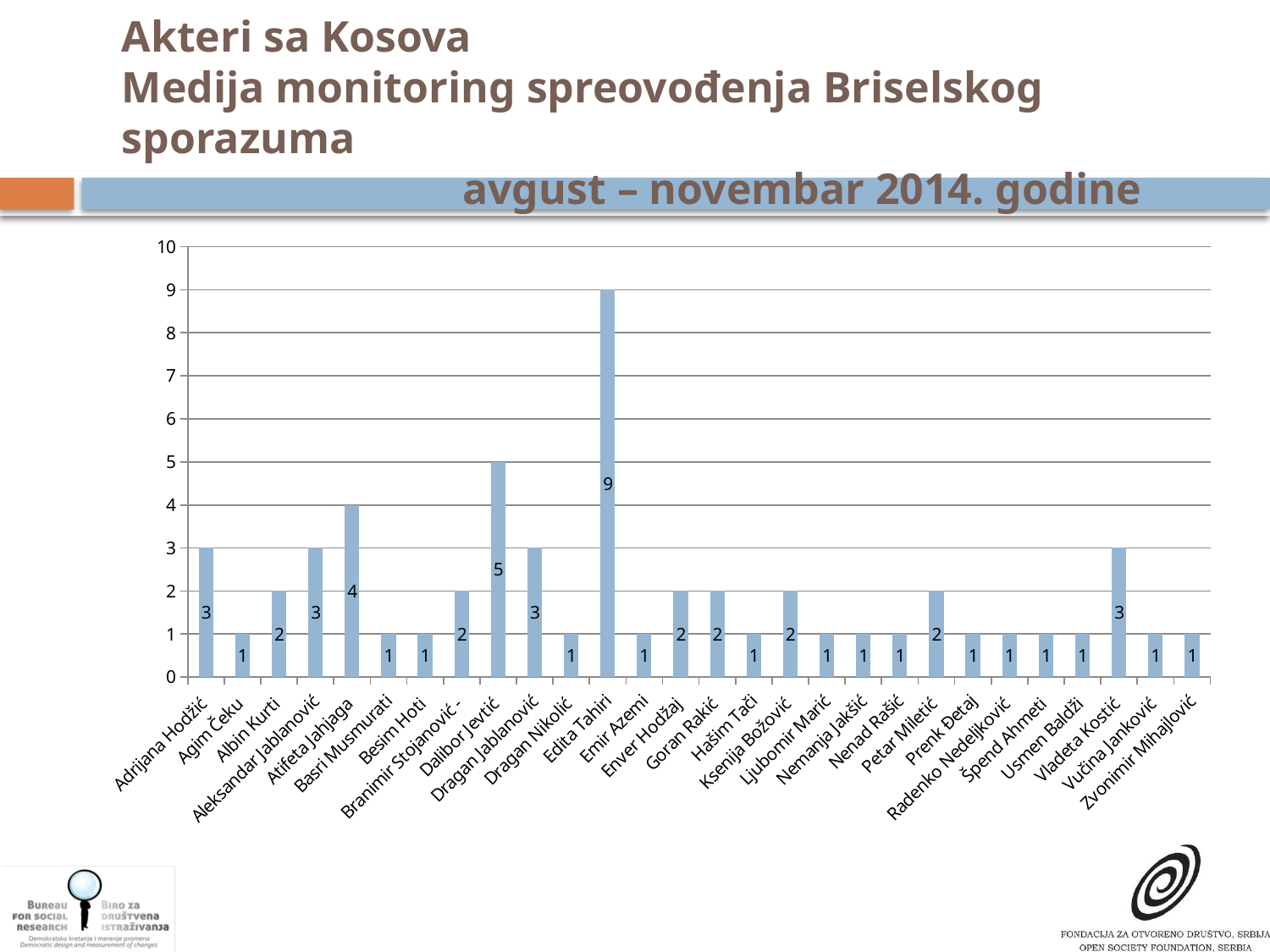
What value is shown for Hašim Tači? 1 Is the value for Edita Tahiri greater or less than 5? greater What kind of chart is shown on the slide? Bar chart What value is shown for Edita Tahiri? 9 What value is shown for Vladeta Kostić? 3 How many people (categories) are shown on the x axis of the chart? 28 Which has a larger value, Atifeta Jahjaga or Dalibor Jevtić? Dalibor Jevtić What is the difference between the values for Atifeta Jahjaga and Adrijana Hodžić? 1 Which person has the highest value in the chart? Edita Tahiri What value is shown for Atifeta Jahjaga? 4 What is the difference between the values for Edita Tahiri and Dalibor Jevtić? 4 What value is shown for Dalibor Jevtić? 5